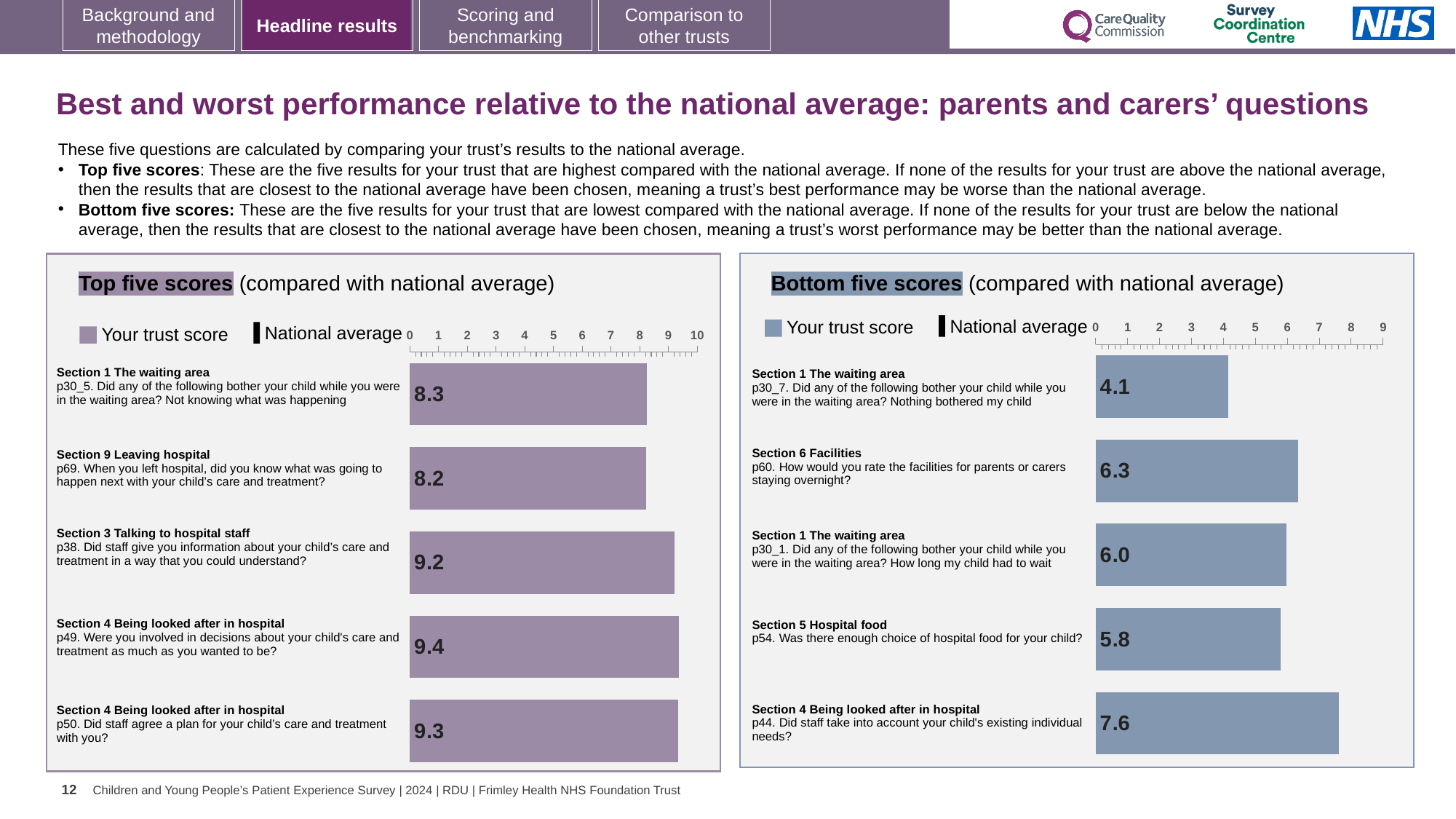
In the Top five scores chart, which question has the lowest trust score? p69. When you left hospital, did you know what was going to happen next with your child's care and treatment? How many questions are shown in the Bottom five scores chart? 5 What kind of chart is the Top five scores chart? Bar chart In the Bottom five scores chart, what is the difference between the trust scores for p44 and p30_7? 3.5 In the Bottom five scores chart, which has the larger trust score: p60 or p54? p60 In the Top five scores chart, what is the difference between the trust scores for p49 and p30_5? 1.1 In the Bottom five scores chart, what is the trust score for p60 (How would you rate the facilities for parents or carers staying overnight?)? 6.3 In the Top five scores chart, which question has the highest trust score? p49. Were you involved in decisions about your child's care and treatment as much as you wanted to be? In the Top five scores chart, what is the trust score for p69 (When you left hospital, did you know what was going to happen next with your child's care and treatment?)? 8.2 In the Top five scores chart, what is the trust score for p38 (Did staff give you information about your child's care and treatment in a way that you could understand?)? 9.2 In the Bottom five scores chart, which question has the highest trust score? p44. Did staff take into account your child's existing individual needs? In the Bottom five scores chart, which question has the lowest trust score? p30_7. Did any of the following bother your child while you were in the waiting area? Nothing bothered my child